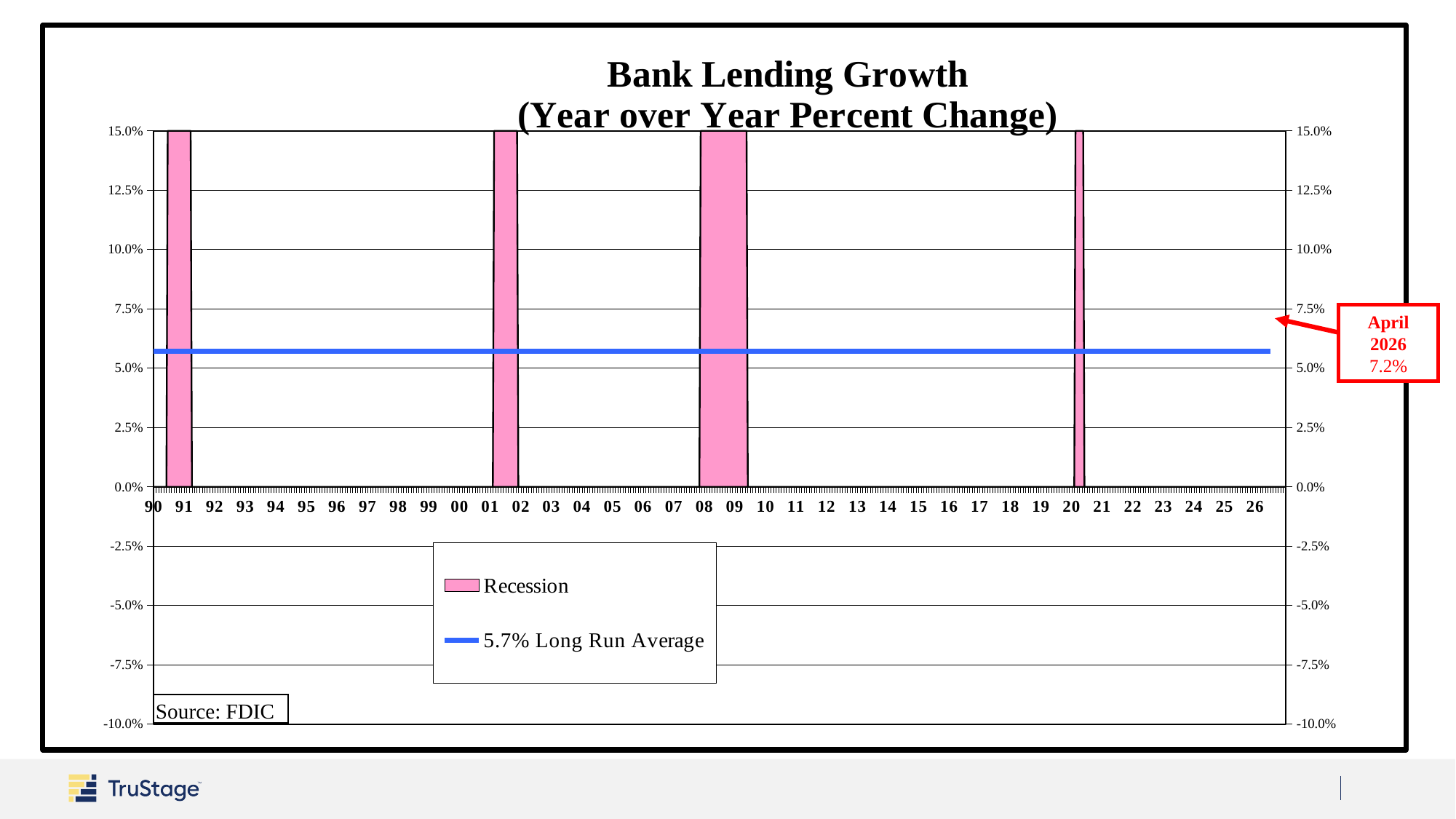
Is the annotated April 2026 value greater or less than the 5.7% long run average? greater Is the 5.7% long run average line above or below the 5.0% gridline? above What is the highest value shown on the chart's vertical axis? 15.0% How many recession periods are shaded on the chart? 4 How many entries does the chart's legend list? 2 What value does the blue horizontal line represent, according to the legend? 5.7% Long Run Average What is the lowest value shown on the chart's vertical axis? -10.0% What is the bank lending growth value annotated for April 2026? 7.2% What is the source cited for the chart's data? FDIC What is the difference between the annotated April 2026 value and the 5.7% long run average? 1.5% What do the pink shaded bars on the chart represent? Recession What is the title of the chart? Bank Lending Growth (Year over Year Percent Change)